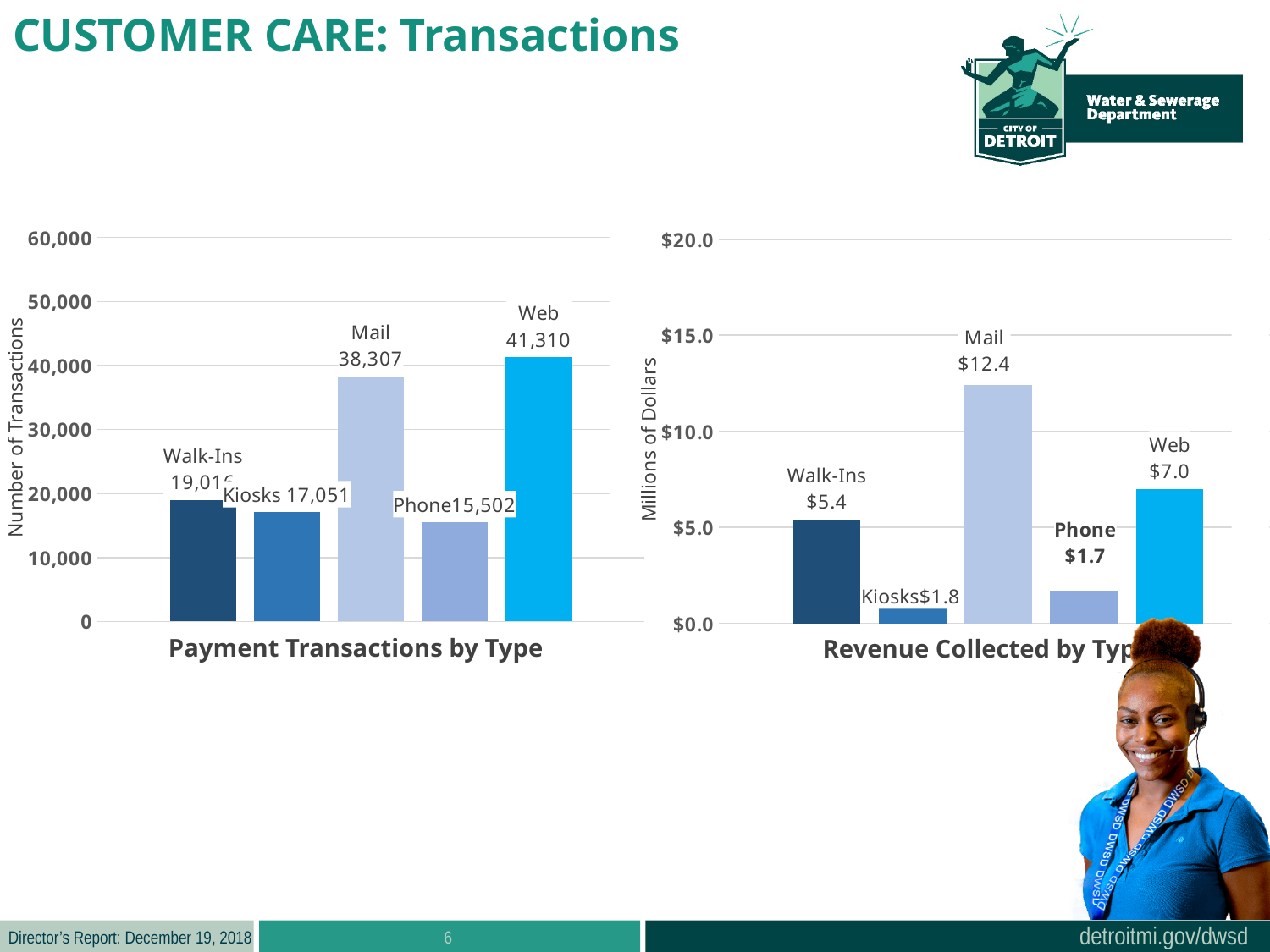
In the Payment Transactions by Type chart, how many payment types are shown? 5 In the Revenue Collected by Type chart, which type collected the most revenue? Mail In the Payment Transactions by Type chart, which payment type has the highest number of transactions? Web In the Payment Transactions by Type chart, how many transactions were made by Mail? 38,307 In the Revenue Collected by Type chart, how much revenue was collected from Walk-Ins? $5.4 In the Payment Transactions by Type chart, which payment type has the lowest number of transactions? Phone What kind of chart is the Revenue Collected by Type chart? bar chart In the Payment Transactions by Type chart, what is the difference between the Web and Mail transaction counts? 3,003 In the Revenue Collected by Type chart, how much revenue was collected by Mail? $12.4 In the Payment Transactions by Type chart, how many transactions were made via Web? 41,310 In the Revenue Collected by Type chart, what is the difference between Mail and Walk-Ins revenue? $7.0 In the Payment Transactions by Type chart, is the value for Kiosks greater or less than 20,000? less